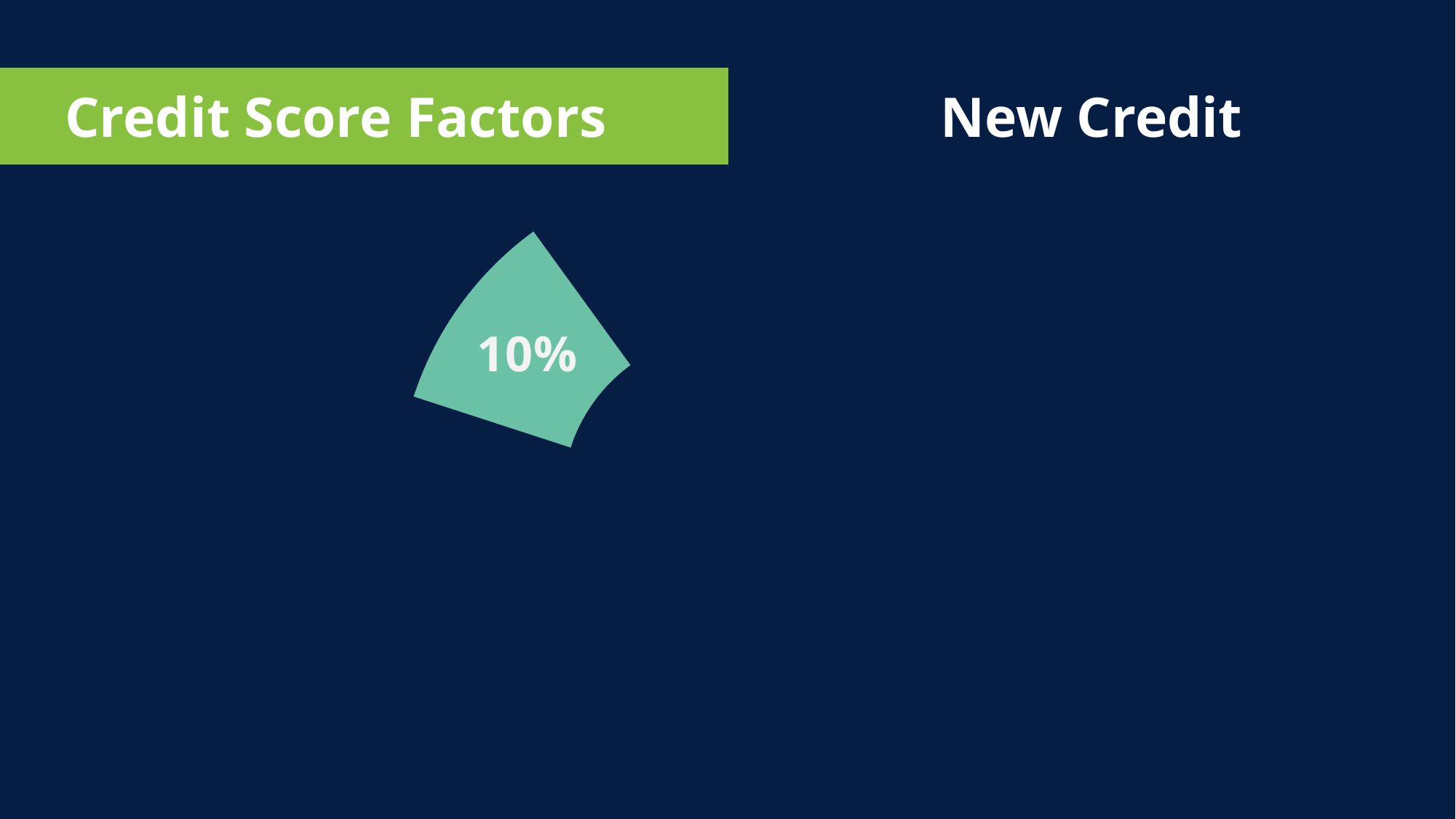
How many pie slices are visible on the slide? 1 Is the value shown on the pie slice greater or less than 50%? less What kind of chart is shown on the slide? doughnut chart What percentage is shown on the visible pie slice? 10% Which credit score factor is labelled on the slide next to the 10% slice? New Credit What share of the credit score does the New Credit slice represent? 10%